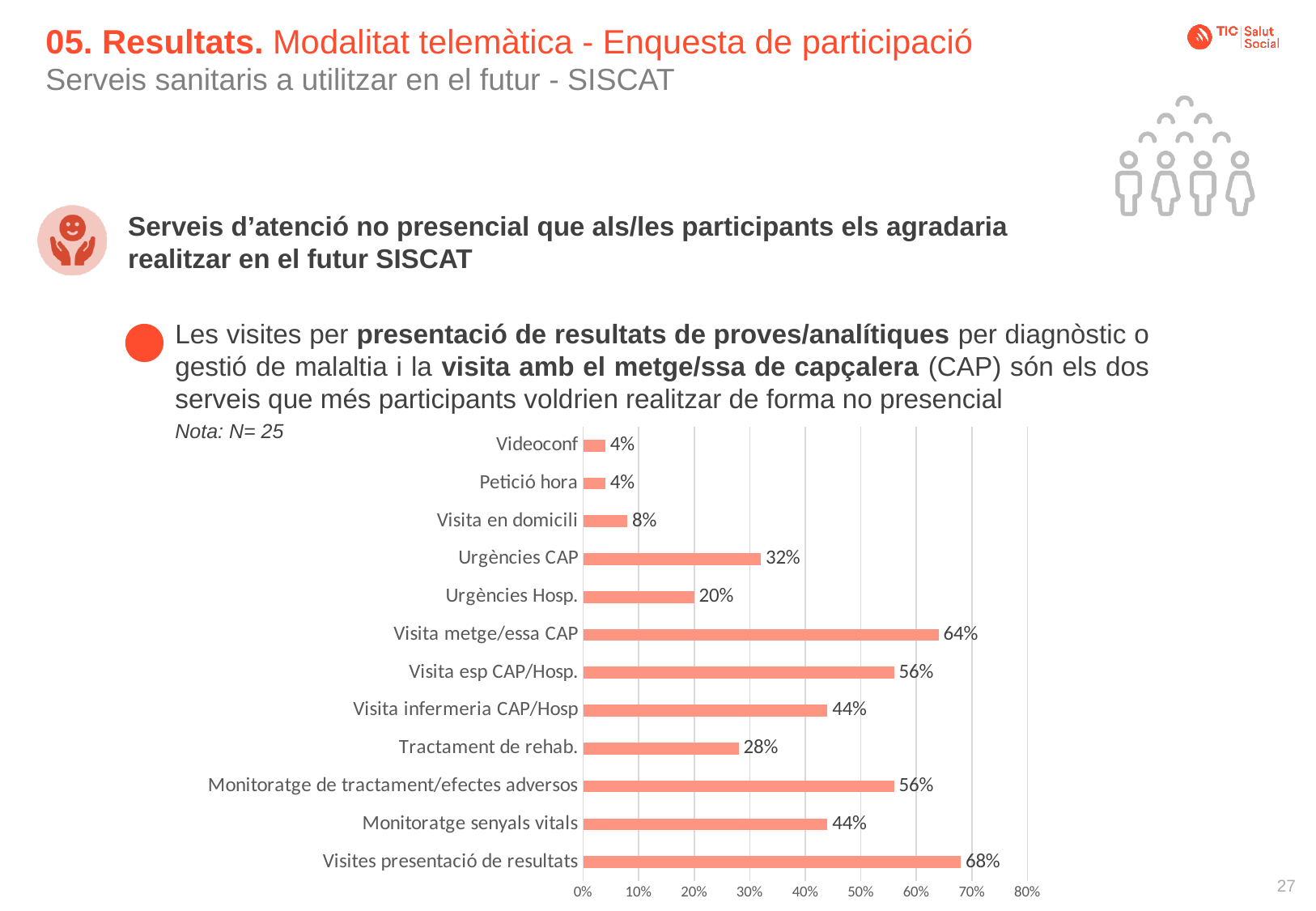
Which category has the highest value? Visites presentació de resultats What is the maximum value shown on the x axis? 80% Is the value for Visita infermeria CAP/Hosp greater or less than 40%? greater What is the value for Visites presentació de resultats? 68% What is the value for Urgències Hosp.? 20% What is the difference between Visita metge/essa CAP and Visita esp CAP/Hosp.? 8% How many categories are shown in the chart? 12 What is the value for Tractament de rehab.? 28% What is the value for Visita metge/essa CAP? 64% What kind of chart is shown on the slide? Bar chart Which is larger, Urgències CAP or Urgències Hosp.? Urgències CAP What is the lowest value shown in the chart? 4%